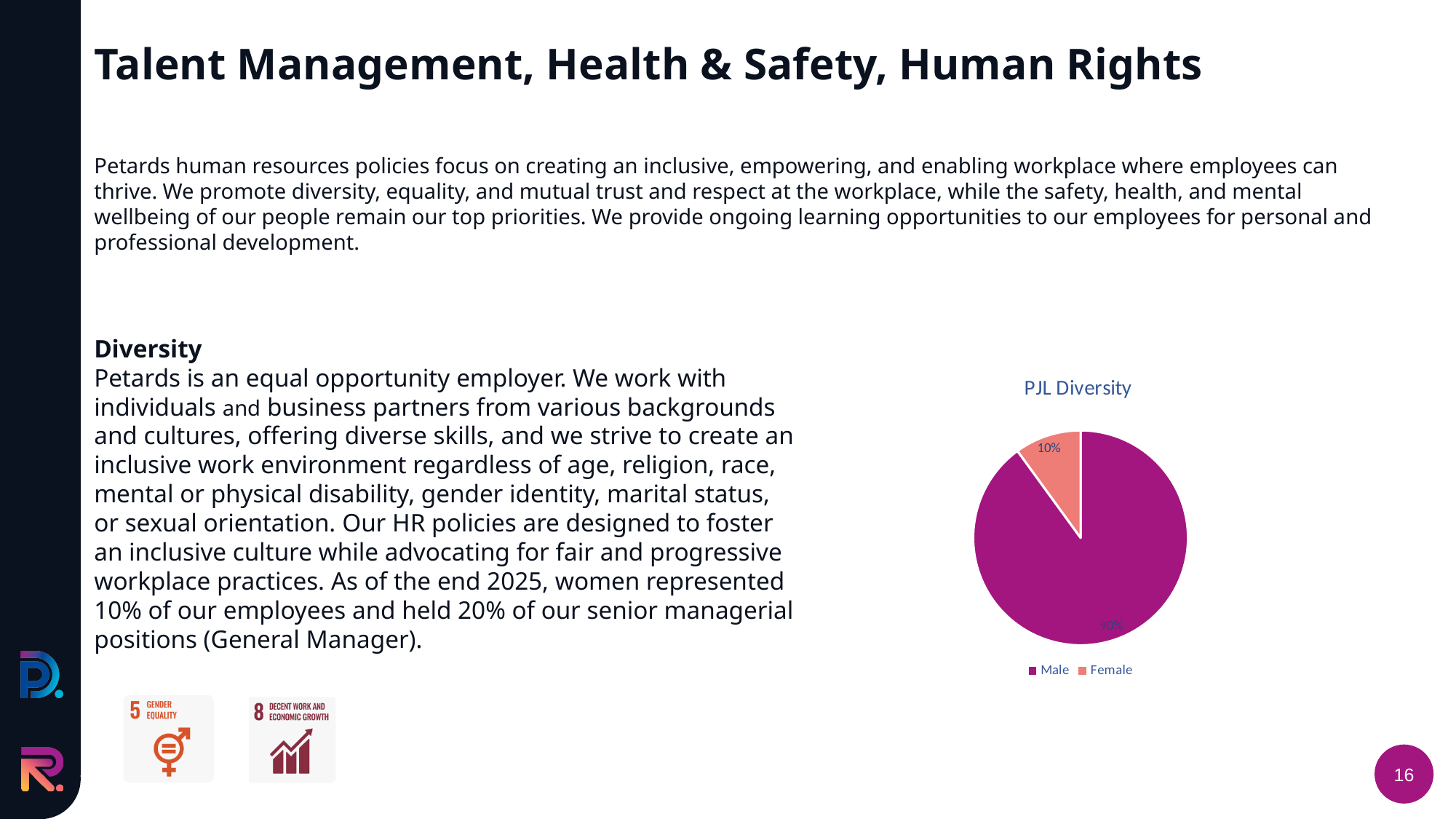
What share of the PJL Diversity pie is Female? 10% What colour is the Female slice in the PJL Diversity pie chart? salmon What kind of chart is the PJL Diversity chart? pie chart Which category has the smallest slice in the PJL Diversity pie chart? Female Which category has the largest slice in the PJL Diversity pie chart? Male What is the title of the pie chart? PJL Diversity How many slices does the PJL Diversity pie chart have? 2 Which is larger in the PJL Diversity chart, Male or Female? Male What share of the PJL Diversity pie is Male? 90% How many entries does the legend of the PJL Diversity chart list? 2 What is the difference in percentage points between the Male and Female slices in the PJL Diversity chart? 80 percentage points